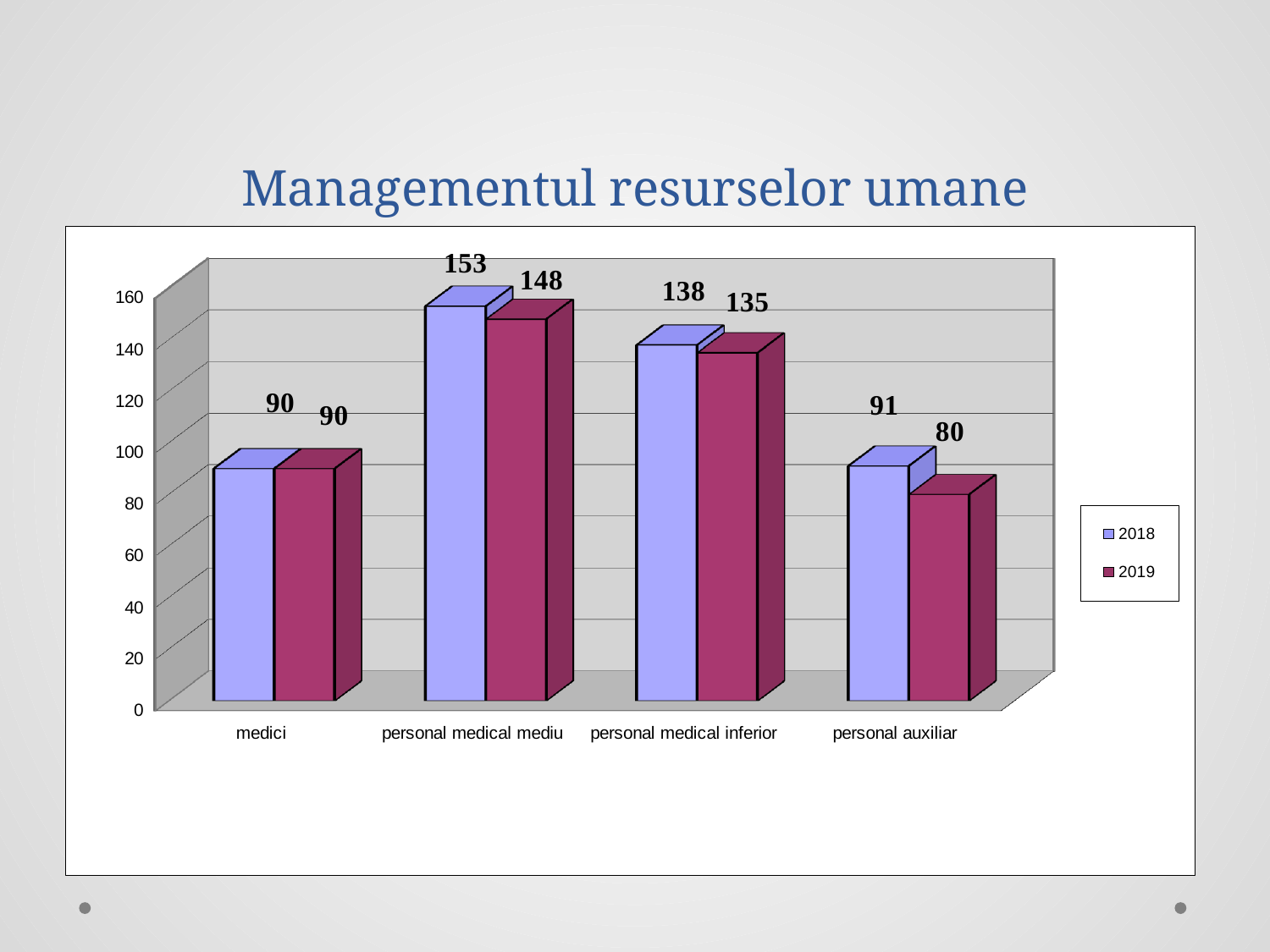
Which category has the lowest value in 2019? personal auxiliar What is the difference between the 2018 and 2019 values for personal auxiliar? 11 What is the title of the slide? Managementul resurselor umane How many series does the legend list? 2 Which is larger, the 2018 value for personal medical inferior or the 2019 value for personal medical inferior? 2018 What is the value for personal medical mediu in 2018? 153 Which category has the highest value in 2018? personal medical mediu How many categories are shown on the x axis? 4 What kind of chart is shown on the slide? bar chart What is the difference between the 2018 and 2019 values for personal medical mediu? 5 What is the value for medici in 2019? 90 What is the value for personal auxiliar in 2019? 80